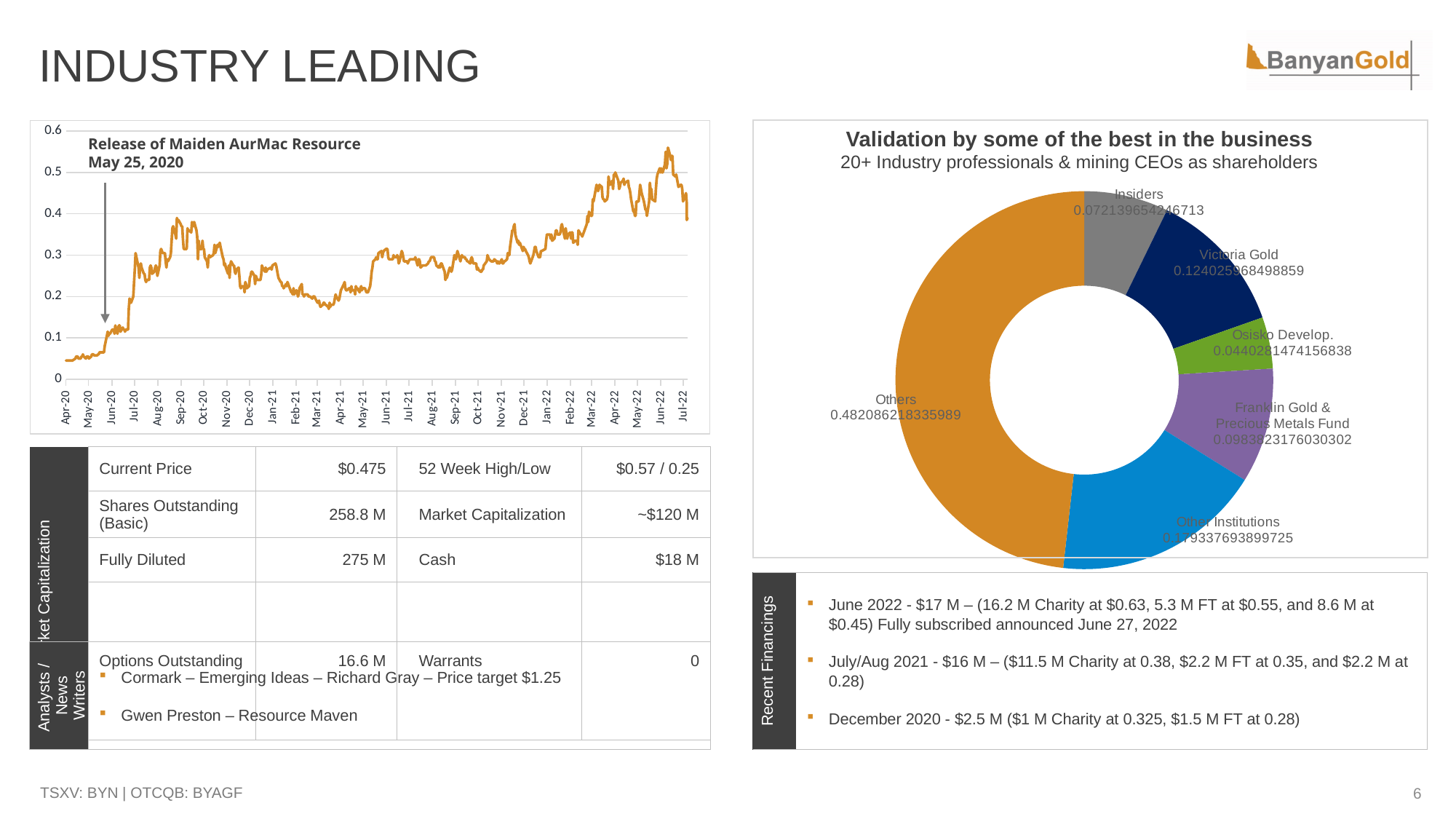
On the line chart in the top left, is the value at Apr-20 greater or less than 0.1? less On the doughnut chart titled 'Validation by some of the best in the business', what value is shown for Victoria Gold? 0.124025968498859 On the doughnut chart on the right, which category has the smallest share? Osisko Develop. How many categories are shown on the doughnut chart on the right? 6 On the line chart in the top left, what event does the annotation mark on May 25, 2020? Release of Maiden AurMac Resource On the line chart in the top left, is the peak value around Jun-22 greater or less than 0.5? greater On the doughnut chart on the right, what value is shown for Other Institutions? 0.179337693899725 On the doughnut chart on the right, which is larger: Insiders or Franklin Gold & Precious Metals Fund? Franklin Gold & Precious Metals Fund On the doughnut chart on the right, what value is shown for Osisko Develop.? 0.0440281474156838 On the doughnut chart on the right, which category has the largest share? Others What type of chart is shown on the right side of the slide? Doughnut chart What type of chart is shown in the top left of the slide? Line chart